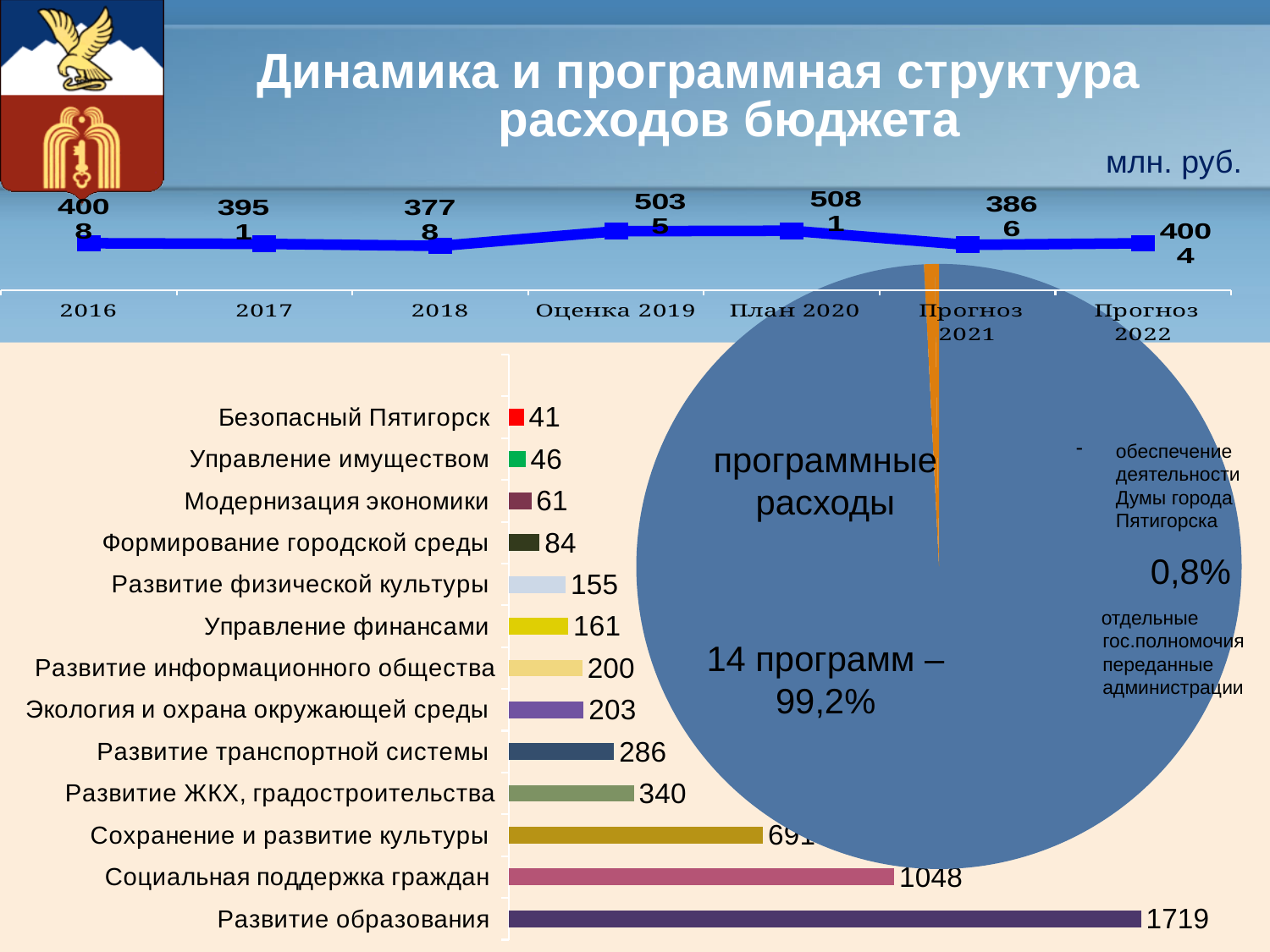
What kind of chart is the chart at the bottom left of the slide? bar chart In the horizontal bar chart at the bottom left, what is the difference between Развитие образования and Социальная поддержка граждан? 671 How many categories does the horizontal bar chart at the bottom left show? 13 In the horizontal bar chart at the bottom left, which is larger: Экология и охрана окружающей среды or Развитие информационного общества? Экология и охрана окружающей среды In the horizontal bar chart at the bottom left, what is the value for Социальная поддержка граждан? 1048 In the horizontal bar chart at the bottom left, what is the value for Развитие образования? 1719 In the horizontal bar chart at the bottom left, what is the value for Развитие транспортной системы? 286 How many data points does the line chart at the top of the slide show? 7 In the horizontal bar chart at the bottom left, which category has the lowest value? Безопасный Пятигорск In the pie chart on the right, what share is labelled for программные расходы (14 программ)? 99,2% In the horizontal bar chart at the bottom left, which category has the highest value? Развитие образования In the line chart at the top of the slide, does the line rise or fall from 2018 to Оценка 2019? rise